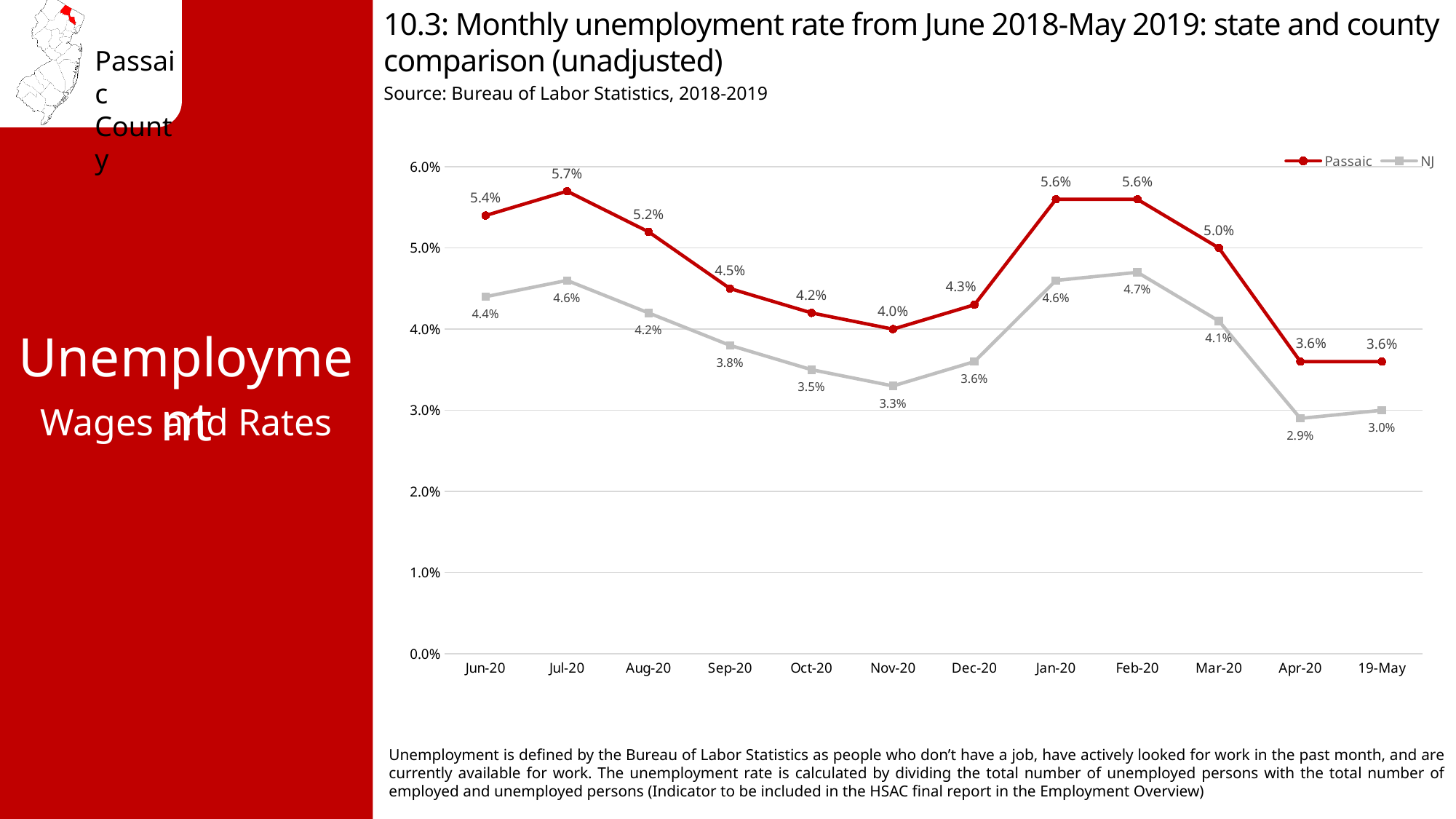
Which series is drawn in red? Passaic How many months are plotted on the x axis? 12 In which month does the Passaic series reach its highest value? Jul-20 Which series has the higher value in Feb-20, Passaic or NJ? Passaic What is the Passaic unemployment rate for Jul-20? 5.7% What is the NJ unemployment rate for Nov-20? 3.3% What is the difference between the Passaic and NJ rates in Jan-20? 1.0% What type of chart is shown on the slide? line chart Does the Passaic series rise or fall from Jul-20 to Nov-20? fall How many series does the legend list? 2 In which month does the NJ series reach its lowest value? Apr-20 What is the Passaic unemployment rate for Mar-20? 5.0%